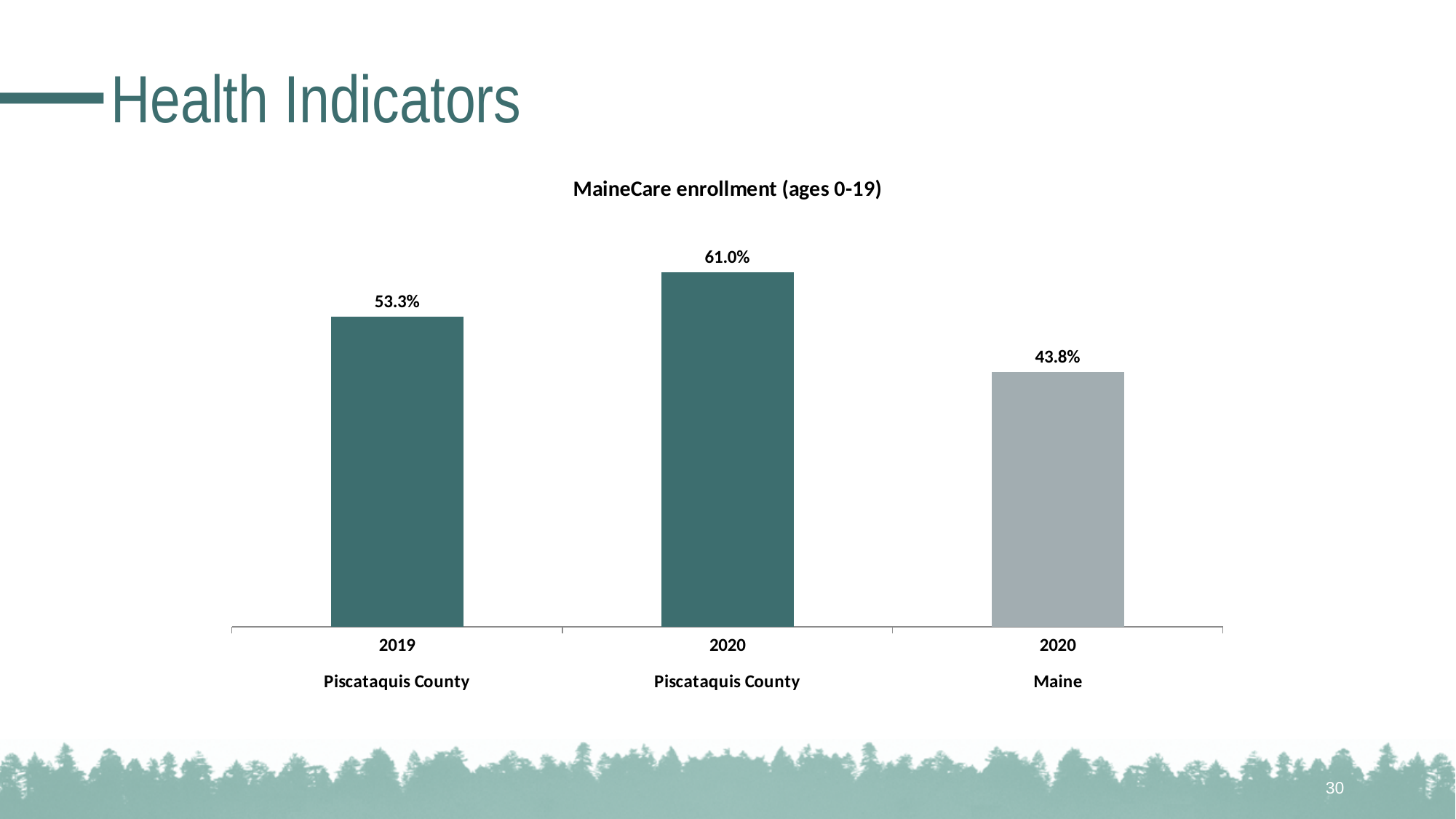
How many bars are shown in the MaineCare enrollment chart? 3 What is the MaineCare enrollment (ages 0-19) value for Piscataquis County in 2020? 61.0% What is the MaineCare enrollment (ages 0-19) value for Piscataquis County in 2019? 53.3% What is the difference between the Piscataquis County 2020 value and the Maine 2020 value? 17.2% What is the MaineCare enrollment (ages 0-19) value for Maine in 2020? 43.8% What is the difference between the Piscataquis County 2020 value and the Piscataquis County 2019 value? 7.7% Which bar has the lowest value in the MaineCare enrollment chart? Maine 2020 Did the MaineCare enrollment value for Piscataquis County rise or fall from 2019 to 2020? Rise What is the title of the chart on the slide? MaineCare enrollment (ages 0-19) Which bar has the highest value in the MaineCare enrollment chart? Piscataquis County 2020 What kind of chart is shown on the slide? Bar chart Which is larger in 2020: the value for Piscataquis County or the value for Maine? Piscataquis County